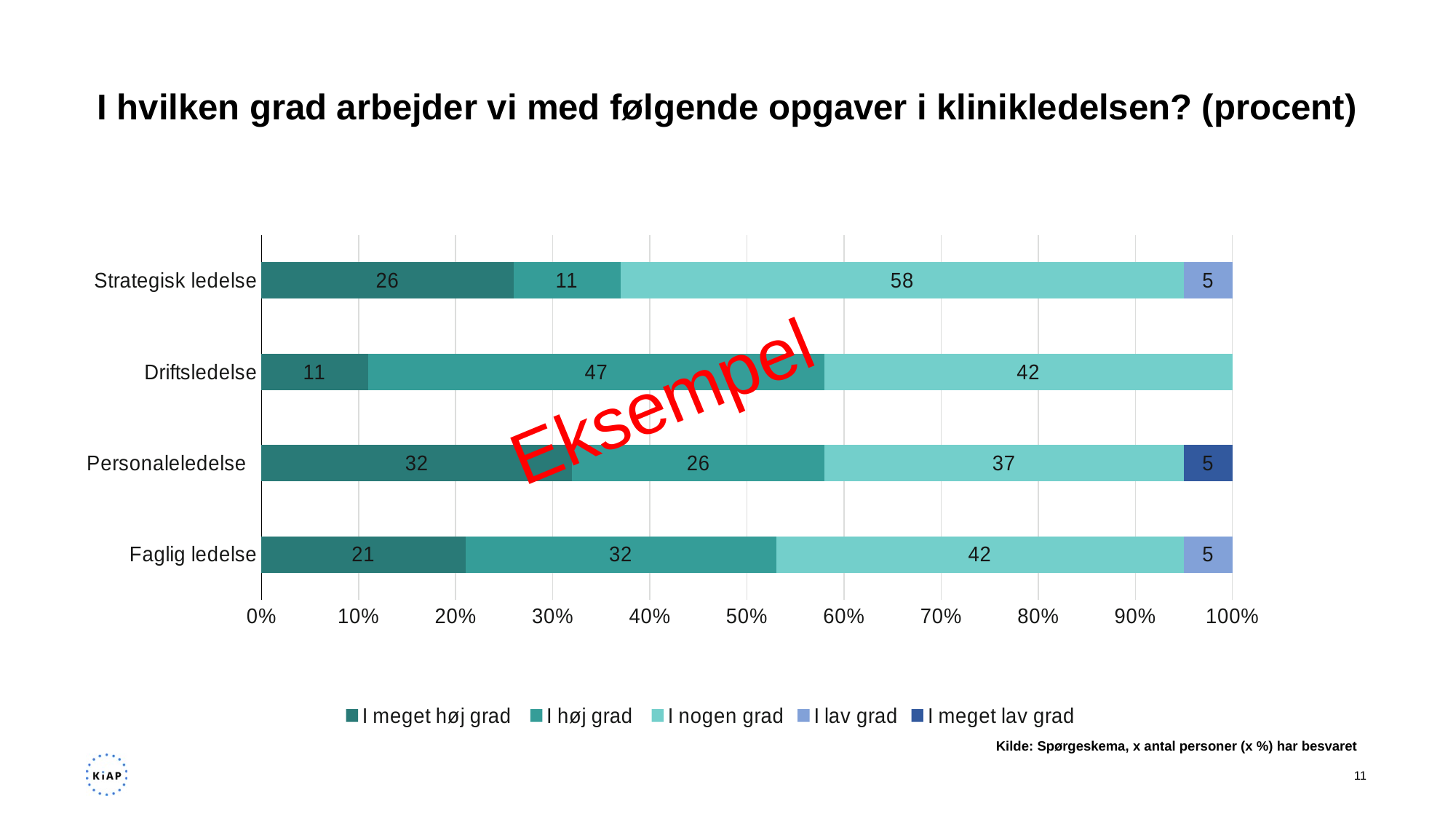
What is the value of 'I meget lav grad' for Personaleledelse? 5 How many categories are shown on the chart? 4 What is the value of 'I meget høj grad' for Personaleledelse? 32 Which category has the highest value for 'I meget høj grad'? Personaleledelse What is the value of 'I nogen grad' for Strategisk ledelse? 58 How many series does the legend list? 5 Which is larger: 'I høj grad' for Faglig ledelse or 'I høj grad' for Personaleledelse? Faglig ledelse What is the title of the chart? I hvilken grad arbejder vi med følgende opgaver i klinikledelsen? (procent) Which category has the lowest value for 'I meget høj grad'? Driftsledelse What is the difference between the 'I nogen grad' values for Strategisk ledelse and Faglig ledelse? 16 What is the value of 'I høj grad' for Driftsledelse? 47 What type of chart is shown on the slide? Stacked bar chart